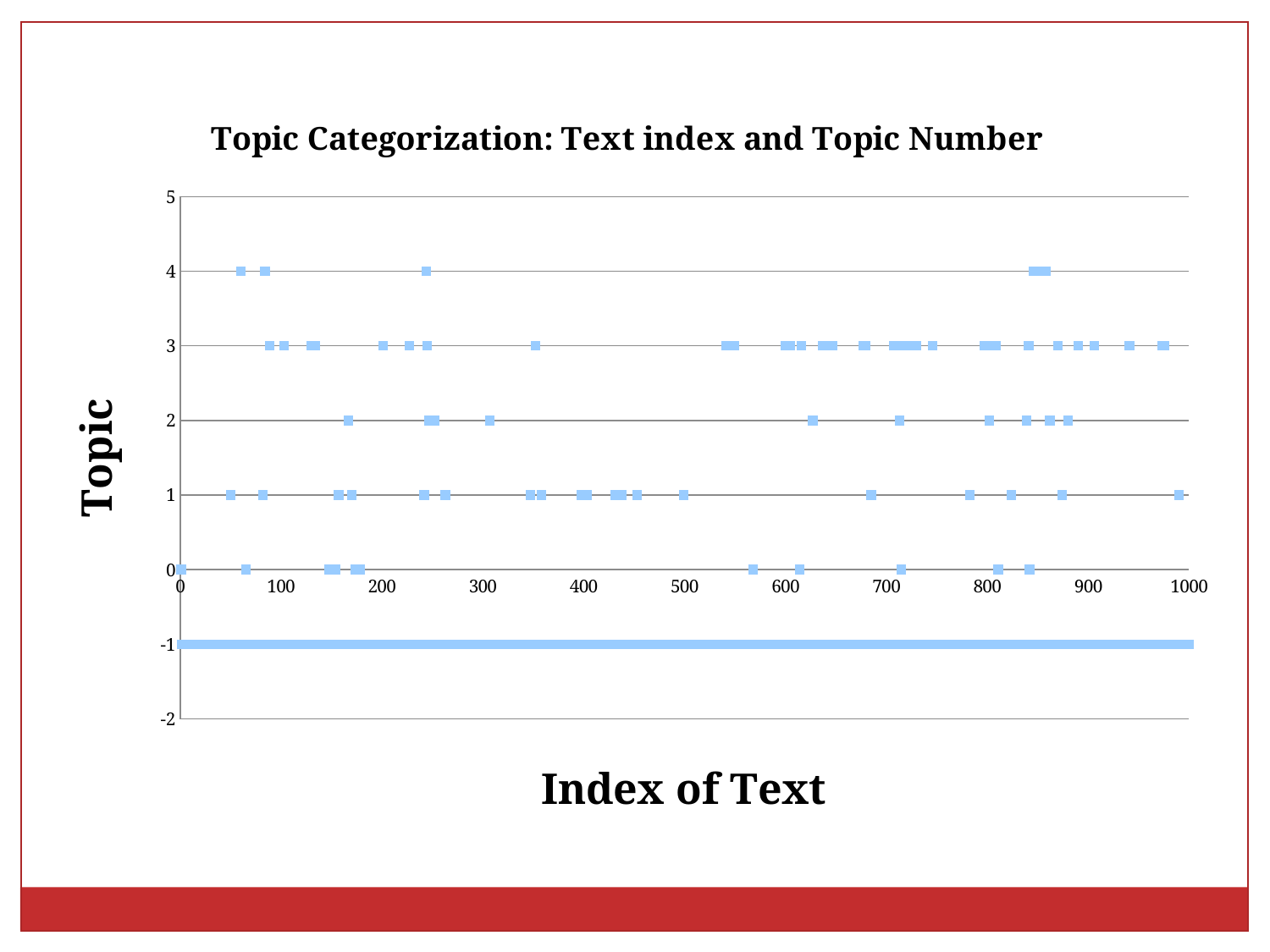
What are the labels of the x axis and the y axis? Index of Text (x axis) and Topic (y axis) Which topic value has the most points plotted along the x axis? -1 What is the highest topic value at which any point is plotted? 4 Are there more points plotted at topic 2 or at topic 1? Topic 1 Are any points plotted at topic value 5? No What kind of chart is shown on the slide? Scatter chart What is the title of the chart? Topic Categorization: Text index and Topic Number What is the lowest value shown on the y axis? -2 What is the lowest topic value at which any point is plotted? -1 Are there more points plotted at topic 3 or at topic 4? Topic 3 How many distinct topic values have points plotted on the chart? 6 What is the largest value shown on the x axis? 1000